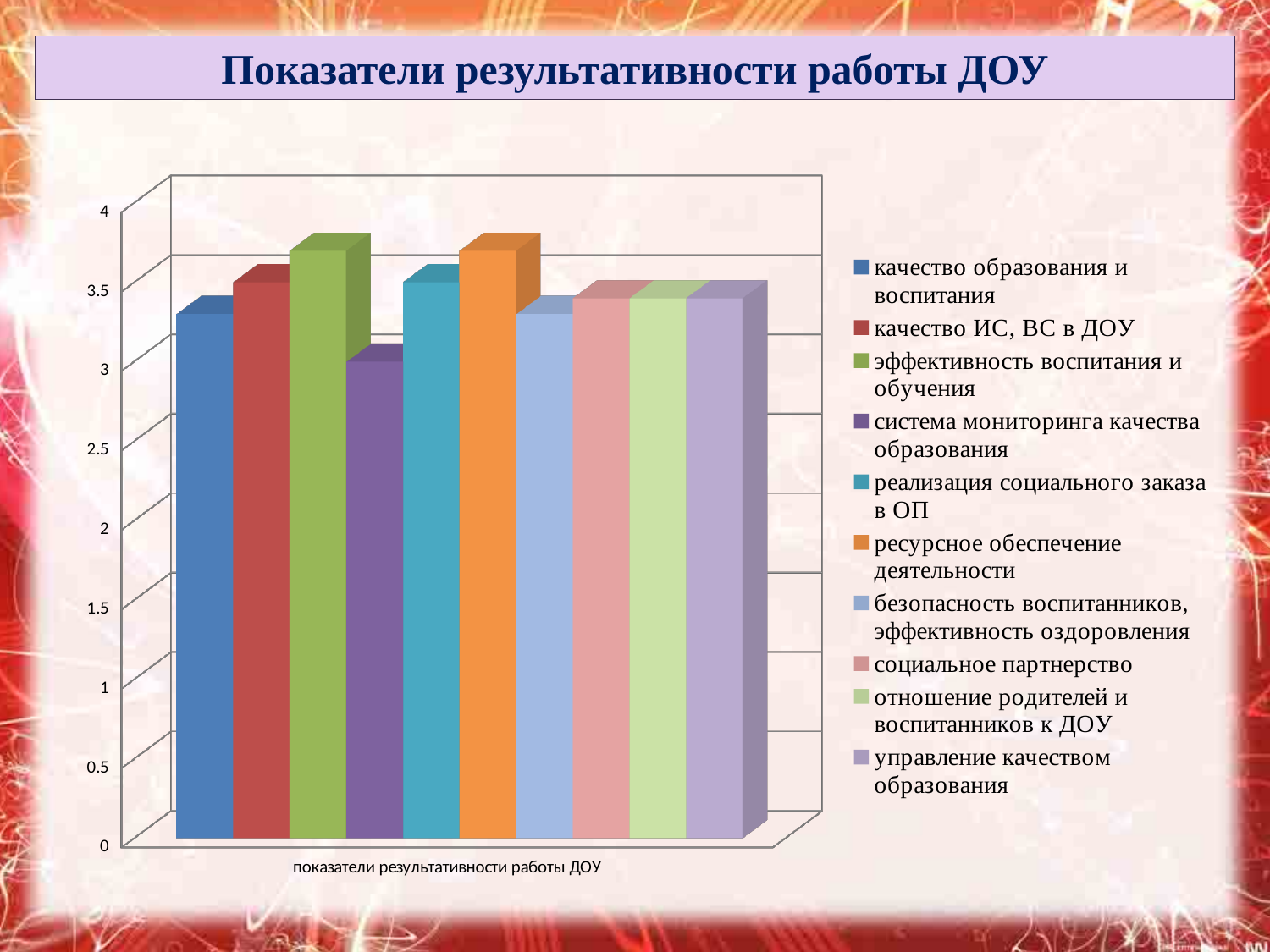
Is the value for "ресурсное обеспечение деятельности" greater or less than 3.5? greater What kind of chart is shown on the slide? bar chart Which is larger: the bar for "эффективность воспитания и обучения" or the bar for "система мониторинга качества образования"? эффективность воспитания и обучения How many categories are shown on the x axis? 1 Which legend entry is shown in orange? ресурсное обеспечение деятельности Which is larger: the bar for "ресурсное обеспечение деятельности" or the bar for "безопасность воспитанников, эффективность оздоровления"? ресурсное обеспечение деятельности Which series has the lowest bar? система мониторинга качества образования Is the value for "эффективность воспитания и обучения" greater or less than 3.5? greater Is the value for "качество образования и воспитания" greater or less than 3.5? less What is the title of the slide above the chart? Показатели результативности работы ДОУ How many series does the legend list? 10